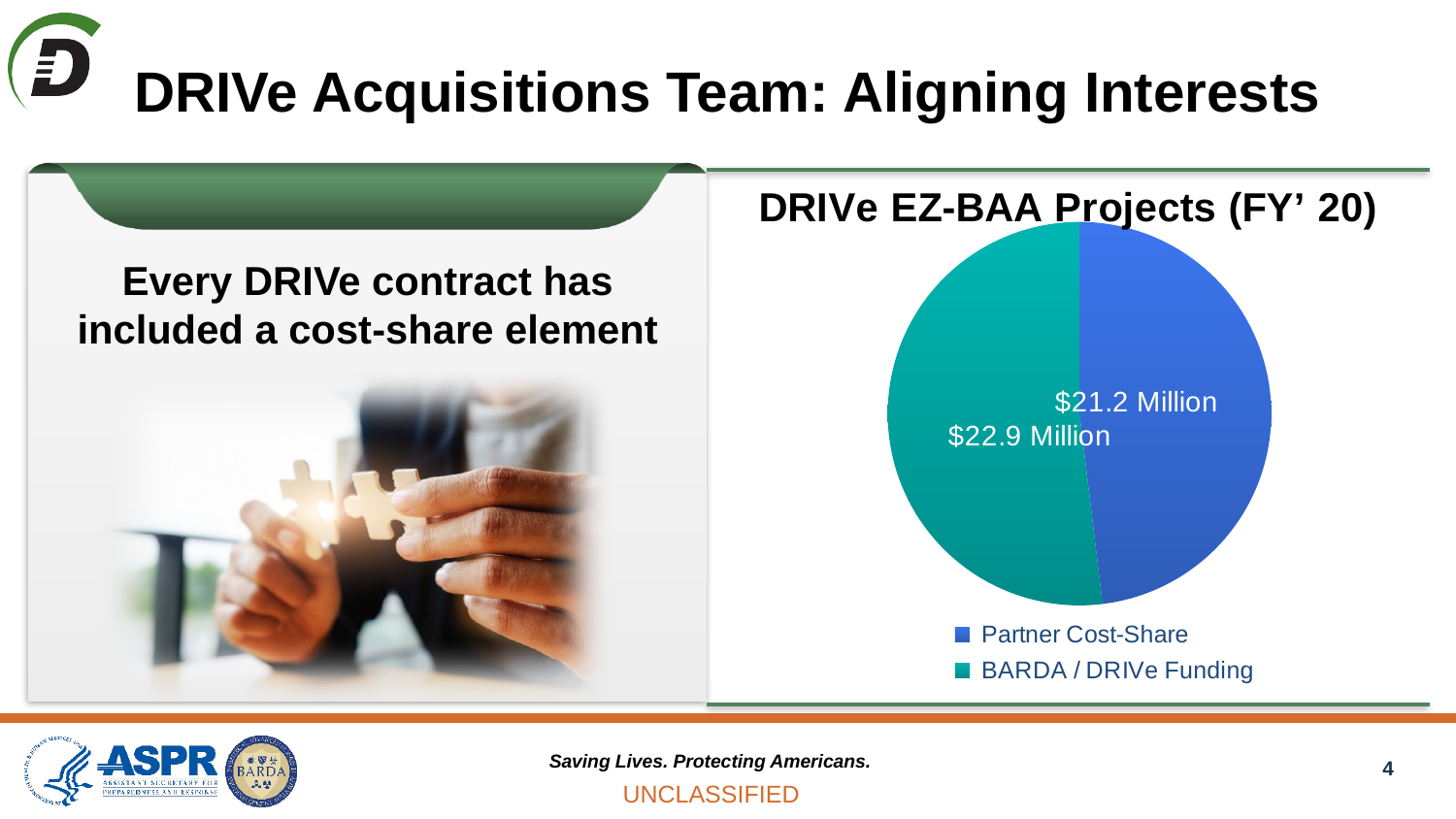
Which slice of the pie is the smallest? Partner Cost-Share What colour is the Partner Cost-Share slice? Blue What is the difference between BARDA / DRIVe Funding and Partner Cost-Share? $1.7 Million What is the combined total of the two slices in the pie chart? $44.1 Million What is the value of the Partner Cost-Share slice? $21.2 Million Which slice of the pie is the largest? BARDA / DRIVe Funding How many entries does the legend list? 2 What is the title of the chart? DRIVe EZ-BAA Projects (FY' 20) What kind of chart is shown on the slide? Pie chart What is the value of the BARDA / DRIVe Funding slice? $22.9 Million How many slices does the pie chart have? 2 Which is larger, Partner Cost-Share or BARDA / DRIVe Funding? BARDA / DRIVe Funding